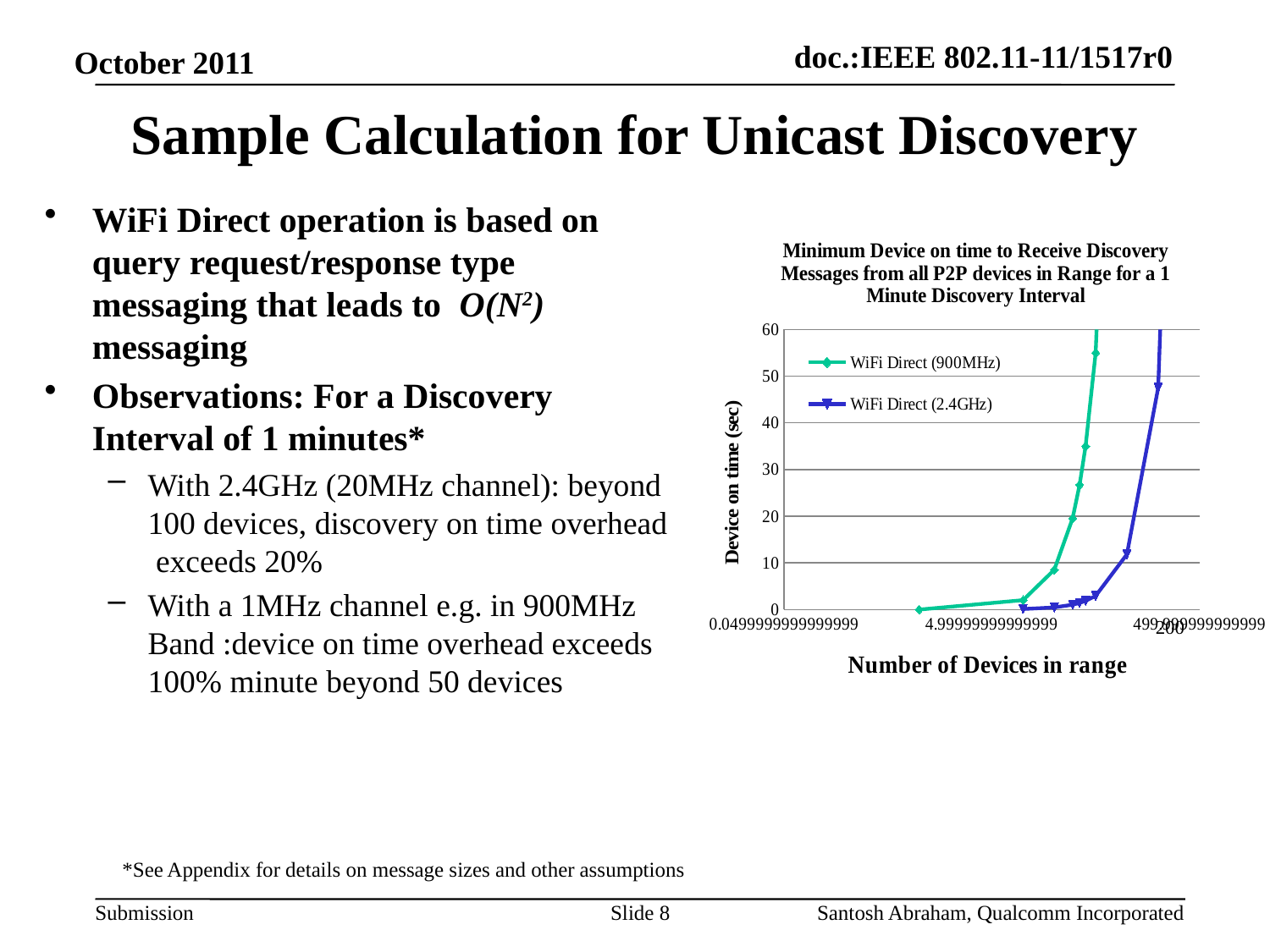
What is the label of the chart's vertical axis? Device on time (sec) Which series is drawn in green on the chart? WiFi Direct (900MHz) What are the two series named in the chart legend? WiFi Direct (900MHz) and WiFi Direct (2.4GHz) How many series does the chart legend list? 2 What kind of chart is shown on the slide? line chart Which series reaches a device on time of 60 seconds at a smaller number of devices in range, WiFi Direct (900MHz) or WiFi Direct (2.4GHz)? WiFi Direct (900MHz) For the same number of devices in range, which series shows the higher device on time, WiFi Direct (900MHz) or WiFi Direct (2.4GHz)? WiFi Direct (900MHz) Do the values for WiFi Direct (900MHz) rise or fall as the number of devices in range increases? rise Do the values for WiFi Direct (2.4GHz) rise or fall as the number of devices in range increases? rise